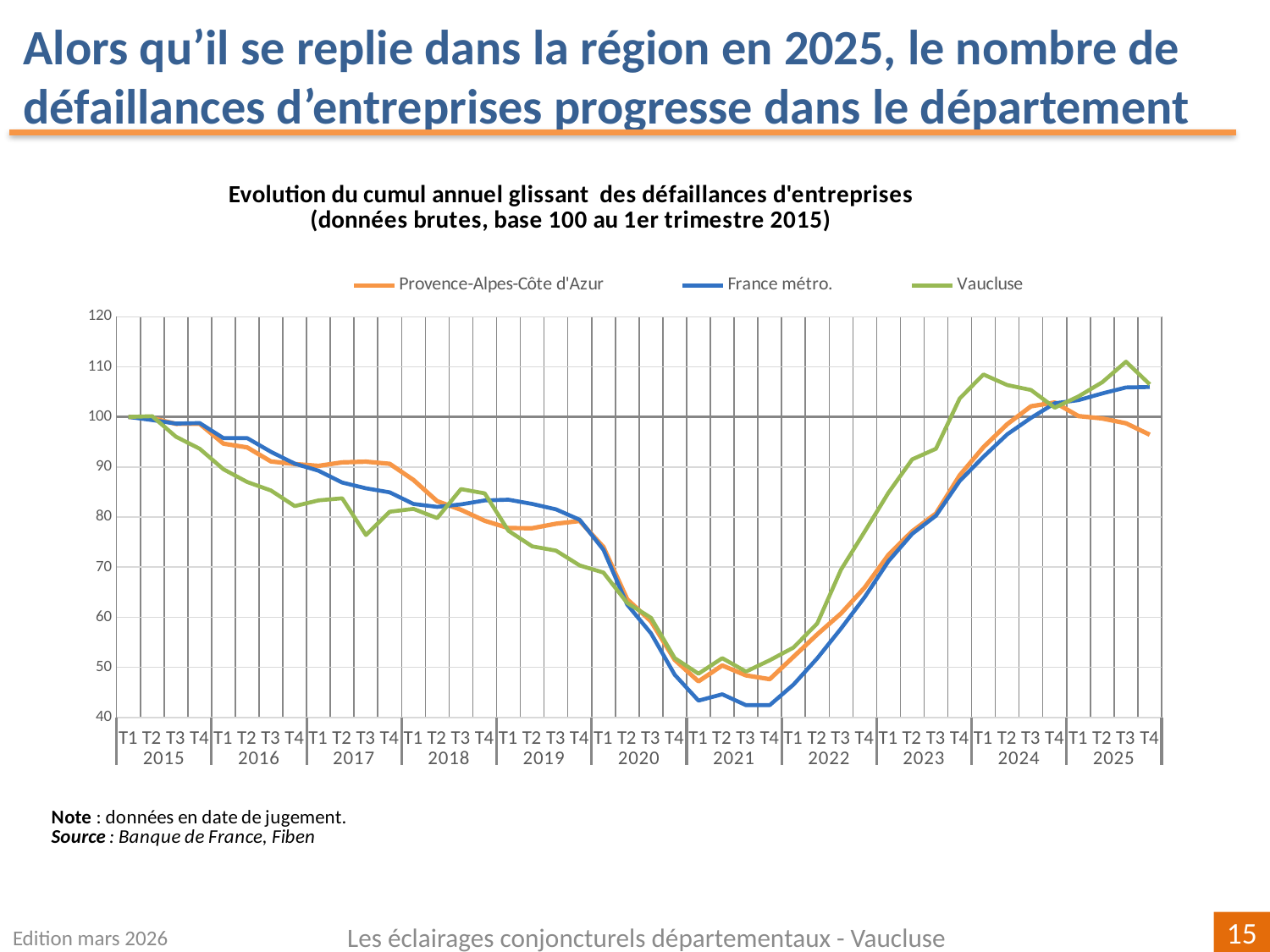
At T4 2025, which is higher: France métro. or Provence-Alpes-Côte d'Azur? France métro. Is the value for Provence-Alpes-Côte d'Azur at T4 2025 greater or less than 100? less What is the value of the France métro. series at T1 2015? 100 Which series are listed in the legend? Provence-Alpes-Côte d'Azur, France métro., Vaucluse How many series does the legend list? 3 What kind of chart is shown on the slide? line chart Which series has the lowest value at T4 2021? France métro. Does the Provence-Alpes-Côte d'Azur series rise or fall over the four quarters of 2025? fall Is the value for France métro. at T4 2021 greater or less than 50? less What is the title of the chart? Evolution du cumul annuel glissant des défaillances d'entreprises (données brutes, base 100 au 1er trimestre 2015) Is the value for Vaucluse at T3 2025 greater or less than 100? greater How many years are shown along the x axis? 11